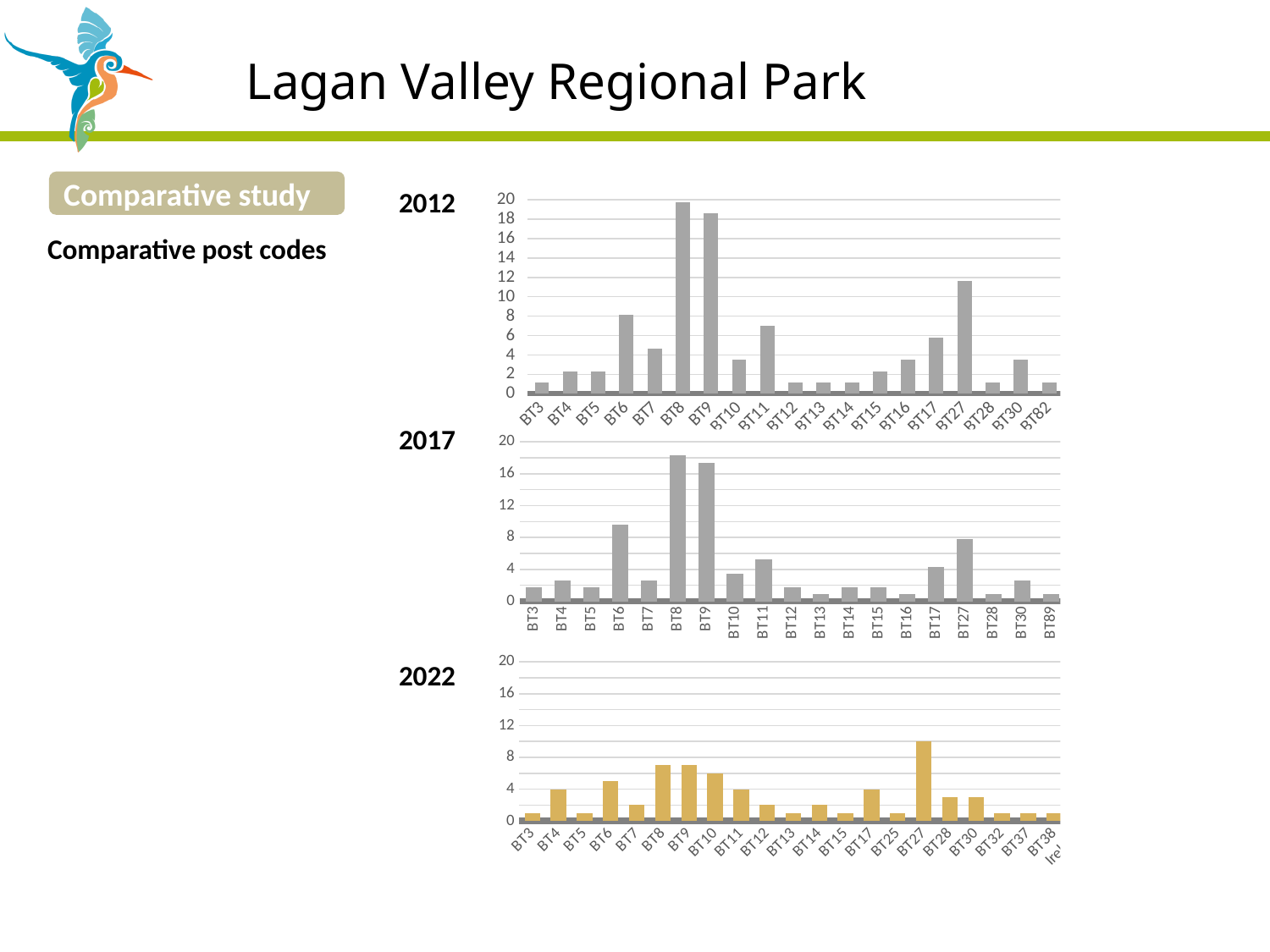
In the 2012 chart, which is larger, the value for BT6 or the value for BT11? BT6 In the 2012 chart, is the value for BT27 greater or less than 10? greater In the 2012 chart, which post code has the highest value? BT8 In the 2022 chart, which is larger, the value for BT6 or the value for BT7? BT6 In the 2017 chart, which post code has the highest value? BT8 In the 2017 chart, which is larger, the value for BT27 or the value for BT17? BT27 What kind of chart is the 2012 chart? bar chart In the 2022 chart, which post code has the highest value? BT27 How many post codes are shown on the x axis of the 2012 chart? 19 In the 2017 chart, is the value for BT6 greater or less than 8? greater What is the highest value shown on the y axis of the 2017 chart? 20 In the 2022 chart, is the value for BT27 greater or less than 8? greater